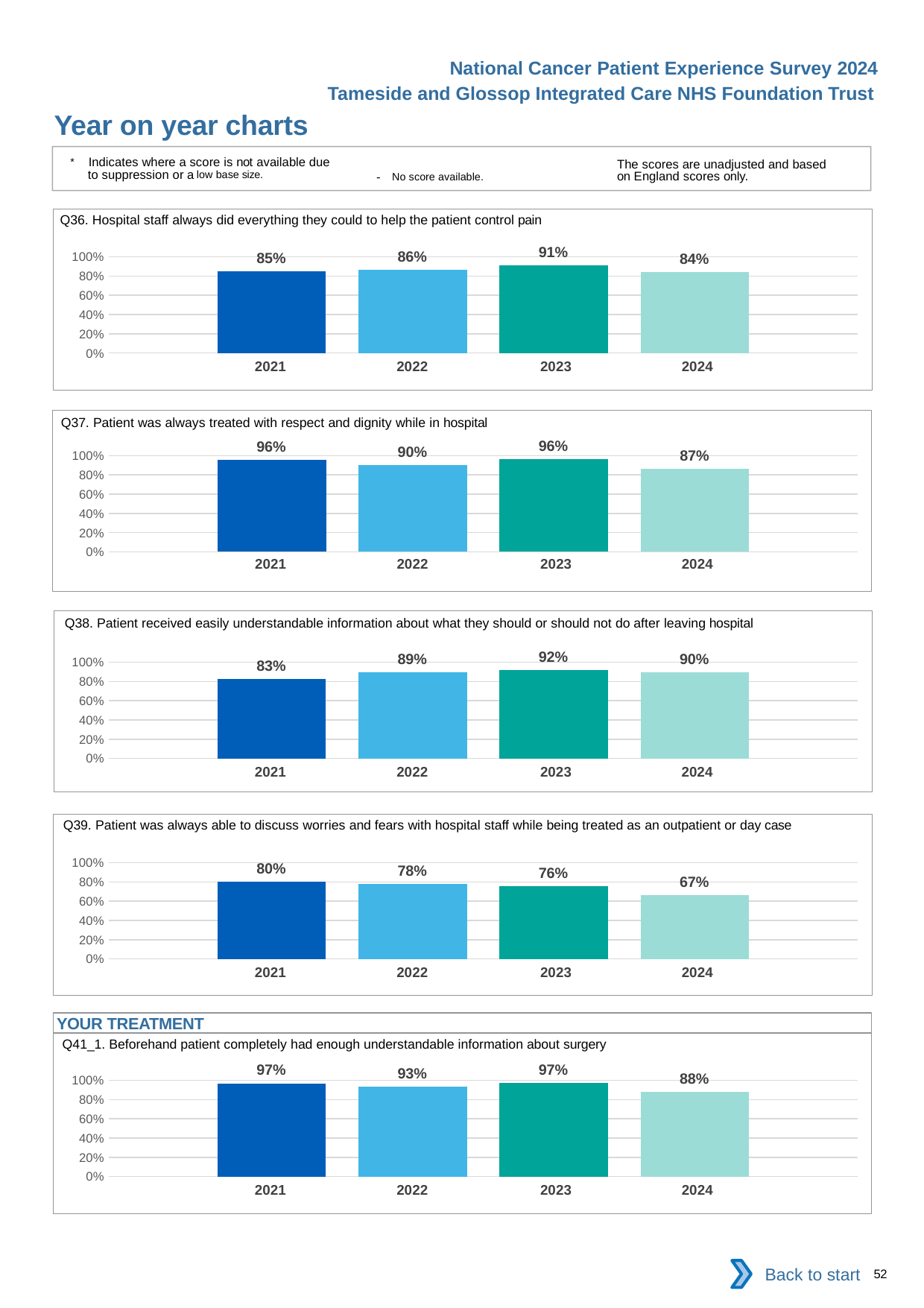
How many years are plotted in the Q36 chart? 4 In the Q37 chart, which year has the lowest value? 2024 In the Q39 chart, do the values rise or fall from 2021 to 2024? Fall In the Q41_1 chart, what is the value for 2024? 88% In the Q38 chart, which year has the highest value? 2023 In the Q41_1 chart, which is larger, the value for 2022 or the value for 2024? 2022 What kind of chart is the Q37 chart? Bar chart In the Q39 chart, is the value for 2024 greater or less than 80%? less In the Q38 chart, what is the difference between the 2023 and 2021 values? 9 percentage points In the Q36 chart, what is the difference between the 2022 and 2024 values? 2 percentage points In the Q36 chart, what is the value for 2023? 91% Which section heading appears above the Q41_1 chart? YOUR TREATMENT